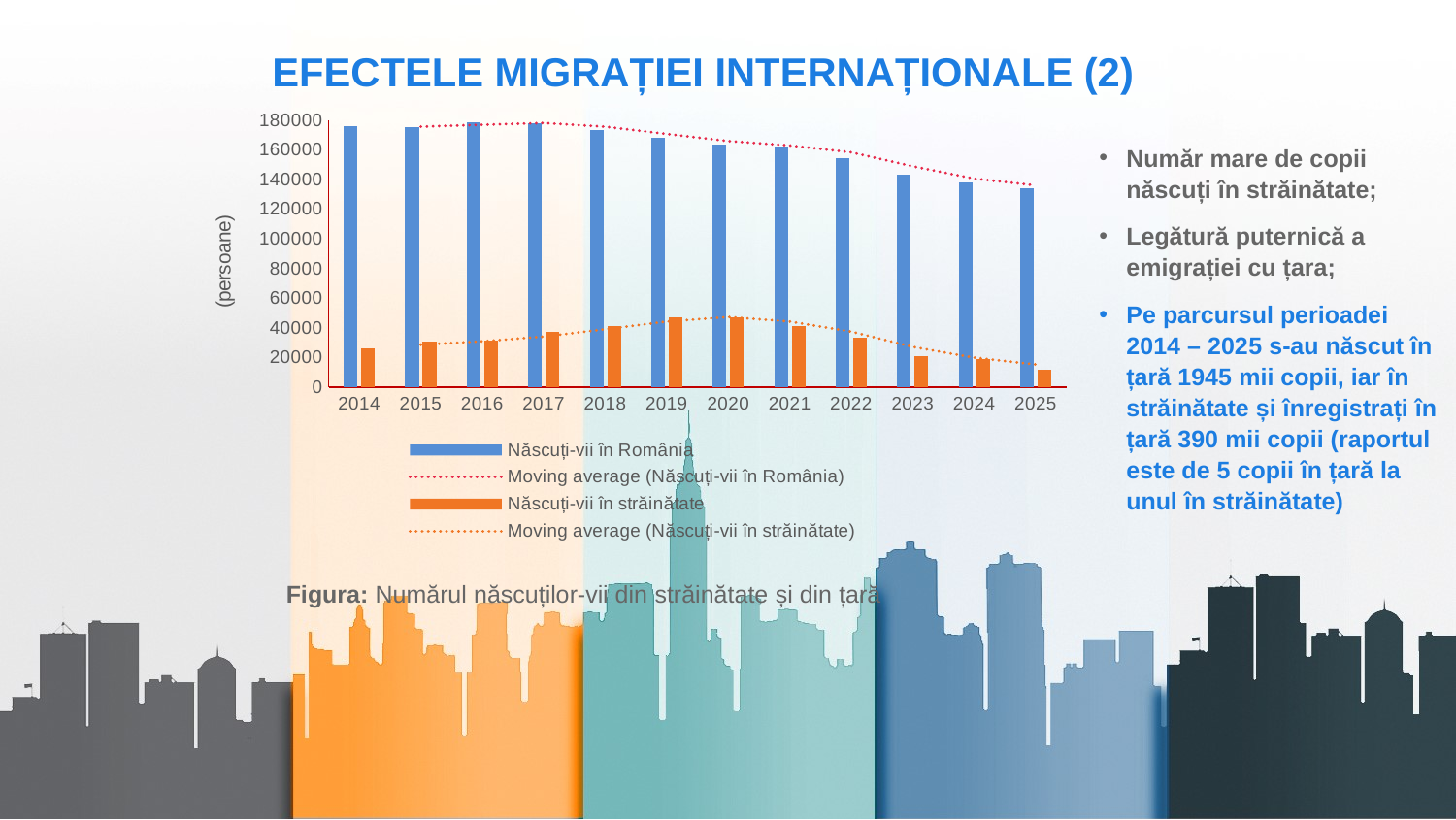
Is the value for Născuți-vii în România in 2025 greater or less than 140000? less Do the values for Născuți-vii în România rise or fall from 2014 to 2025? fall Is the value for Născuți-vii în străinătate in 2020 greater or less than 40000? greater How many entries does the chart legend list? 4 Which is larger, the value for Născuți-vii în România in 2014 or in 2025? 2014 Which year has the lowest value for Născuți-vii în străinătate? 2025 What unit label is shown on the vertical axis of the chart? (persoane) Is the value for Născuți-vii în străinătate in 2025 greater or less than 20000? less Which year has the lowest value for Născuți-vii în România? 2025 What kind of chart is shown on the slide? bar chart How many years are shown on the x axis of the chart? 12